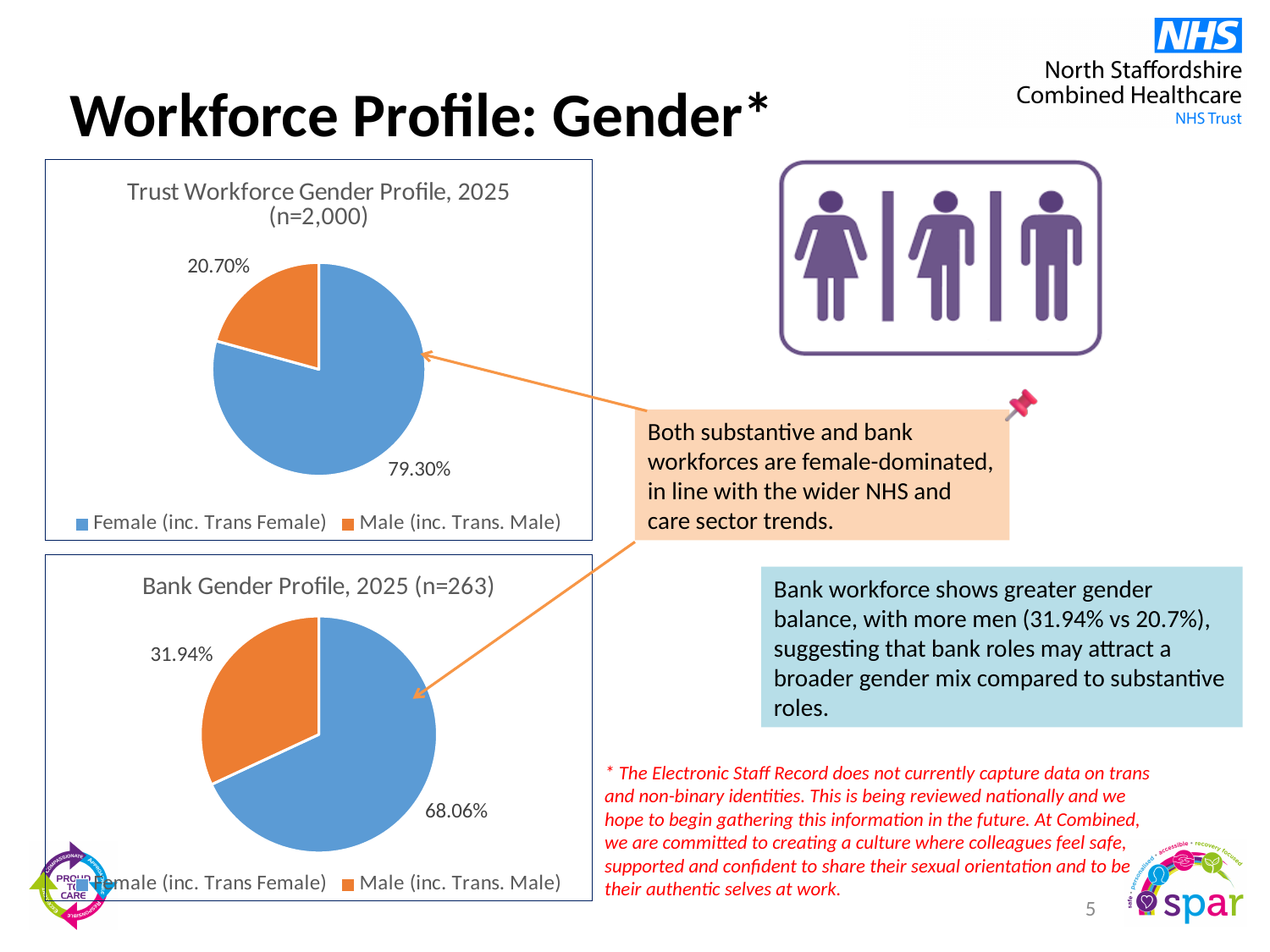
In the 'Bank Gender Profile, 2025 (n=263)' chart, what share is Male (inc. Trans. Male)? 31.94% What kind of chart is the 'Trust Workforce Gender Profile, 2025 (n=2,000)' chart? Pie chart In the 'Bank Gender Profile, 2025 (n=263)' chart, which category has the largest slice? Female (inc. Trans Female) In the 'Trust Workforce Gender Profile, 2025 (n=2,000)' chart, what share is Male (inc. Trans. Male)? 20.70% In the 'Bank Gender Profile, 2025 (n=263)' chart, what share is Female (inc. Trans Female)? 68.06% How many categories does the 'Bank Gender Profile, 2025 (n=263)' pie chart have? 2 In the 'Bank Gender Profile, 2025 (n=263)' chart, what is the difference between the Female and Male shares? 36.12% In the 'Trust Workforce Gender Profile, 2025 (n=2,000)' chart, what colour is the Female (inc. Trans Female) slice? Blue In the 'Trust Workforce Gender Profile, 2025 (n=2,000)' chart, what is the difference between the Female and Male shares? 58.60% In the 'Trust Workforce Gender Profile, 2025 (n=2,000)' chart, what share is Female (inc. Trans Female)? 79.30% Which chart shows a larger Male (inc. Trans. Male) share, the Trust Workforce chart or the Bank Gender Profile chart? Bank Gender Profile In the 'Trust Workforce Gender Profile, 2025 (n=2,000)' chart, which category has the smallest slice? Male (inc. Trans. Male)